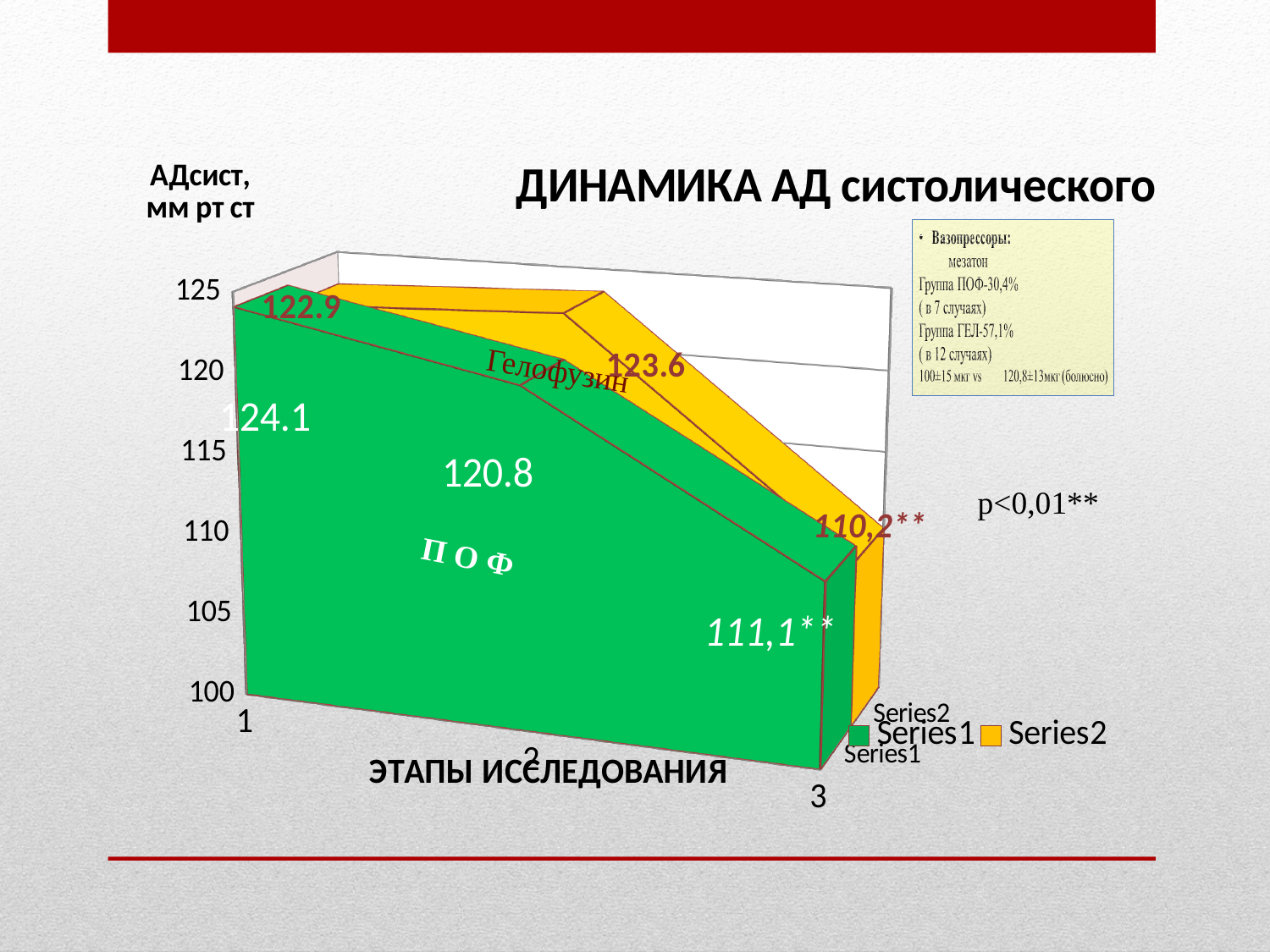
How many series does the legend list? 2 What is the value of Series1 (ПОФ) at stage 2? 120.8 How many stages (categories) are shown on the x axis? 3 What is the value of Series2 (Гелофузин) at stage 1? 122.9 Which is larger at stage 2: Series1 (120.8) or Series2 (123.6)? Series2 What is the value of Series1 (ПОФ) at stage 1? 124.1 What is the difference between the Series1 values at stage 1 and stage 2? 3.3 What type of chart is shown on the slide? area chart Does Series1 (ПОФ) rise or fall from stage 1 to stage 3? fall At which stage is Series1 (ПОФ) highest? 1 What is the value of Series2 (Гелофузин) at stage 2? 123.6 At which stage is Series2 (Гелофузин) lowest? 3